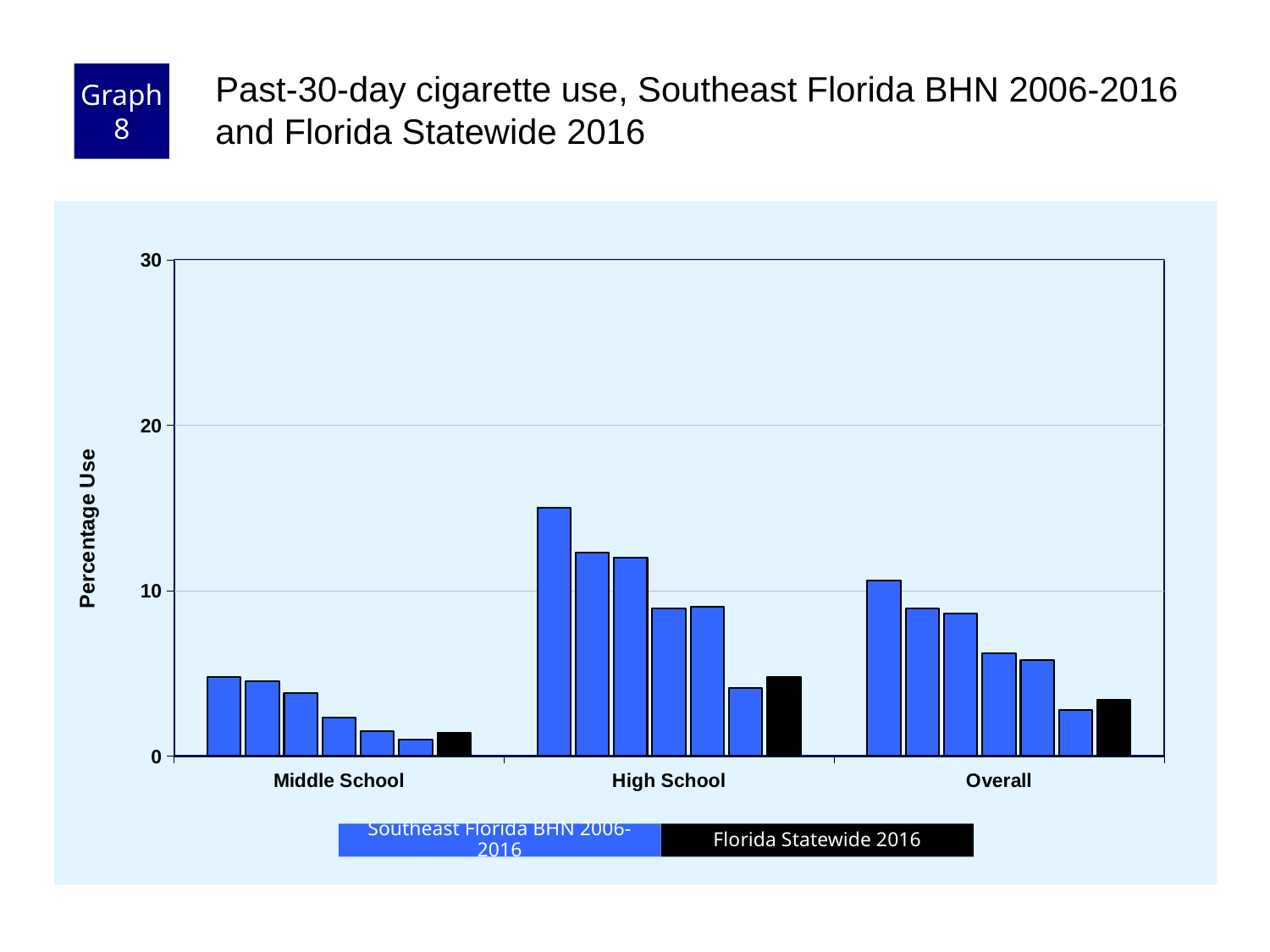
What colour are the Florida Statewide 2016 bars? black Which category has the tallest bar? High School Which is larger, the Florida Statewide 2016 value for High School or for Middle School? High School What is the label on the y axis? Percentage Use Is the Florida Statewide 2016 value for Middle School greater or less than 10? less Within the High School group, do the Southeast Florida BHN 2006-2016 bars generally rise or fall from left to right? fall How many categories are shown on the x axis? 3 How many series does the legend list? 2 Is the tallest bar in the High School group greater or less than 10? greater Is the Florida Statewide 2016 value for High School greater or less than 10? less Which category has the lowest bars overall? Middle School What kind of chart is shown on the slide? bar chart